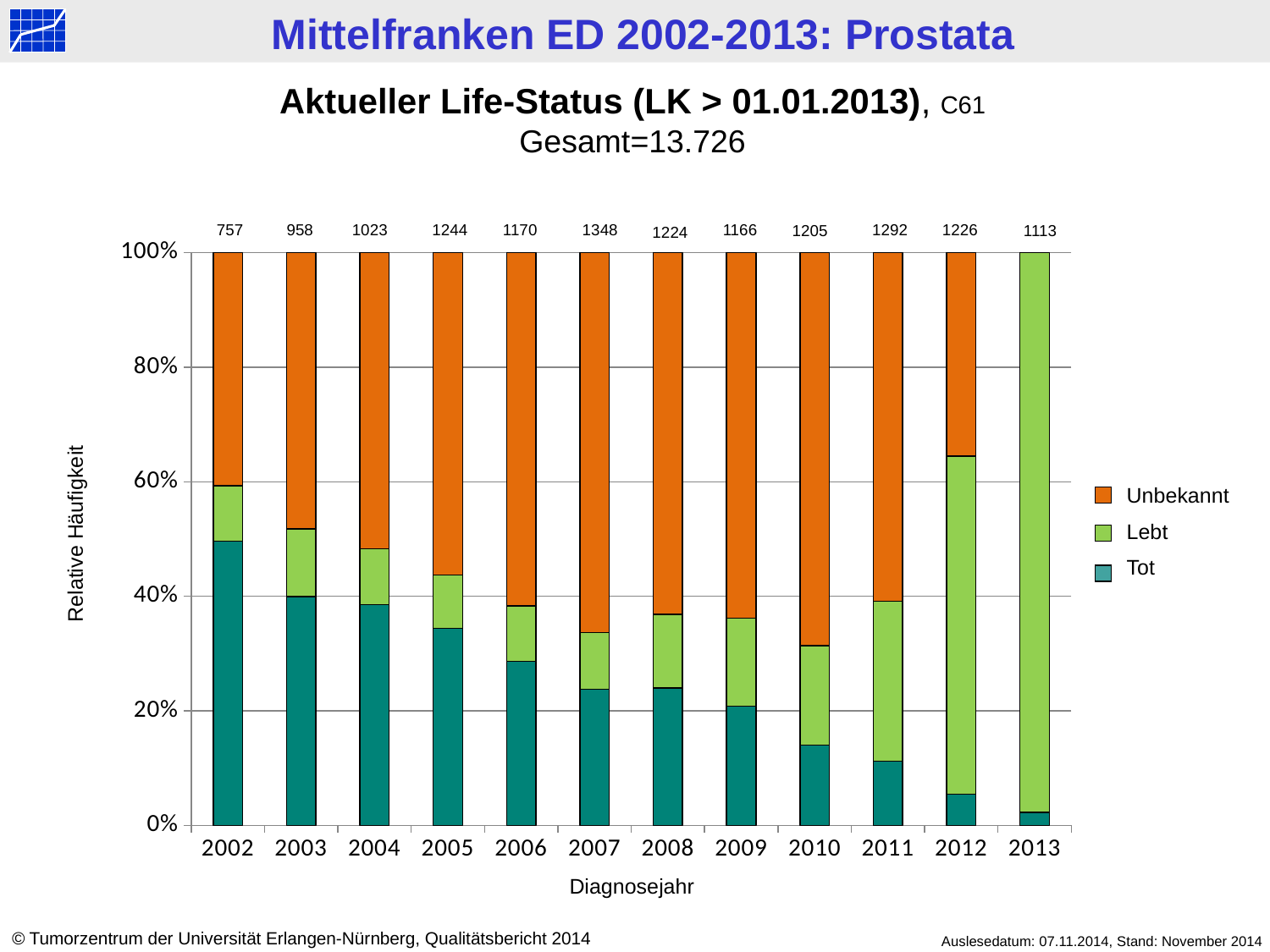
What number is printed above the bar for 2007? 1348 Does the Tot share rise or fall from 2002 to 2013? fall How many diagnosis years are shown on the x axis? 12 How many series does the legend list? 3 Is the Tot share for 2012 greater or less than 20%? less Which year has the larger number printed above its bar, 2005 or 2006? 2005 What number is printed above the bar for 2002? 757 Is the Tot share for 2002 greater or less than 40%? greater What is the difference between the numbers printed above the bars for 2011 and 2010? 87 What number is printed above the bar for 2013? 1113 Which year has the highest number printed above its bar? 2007 Which year has the lowest number printed above its bar? 2002